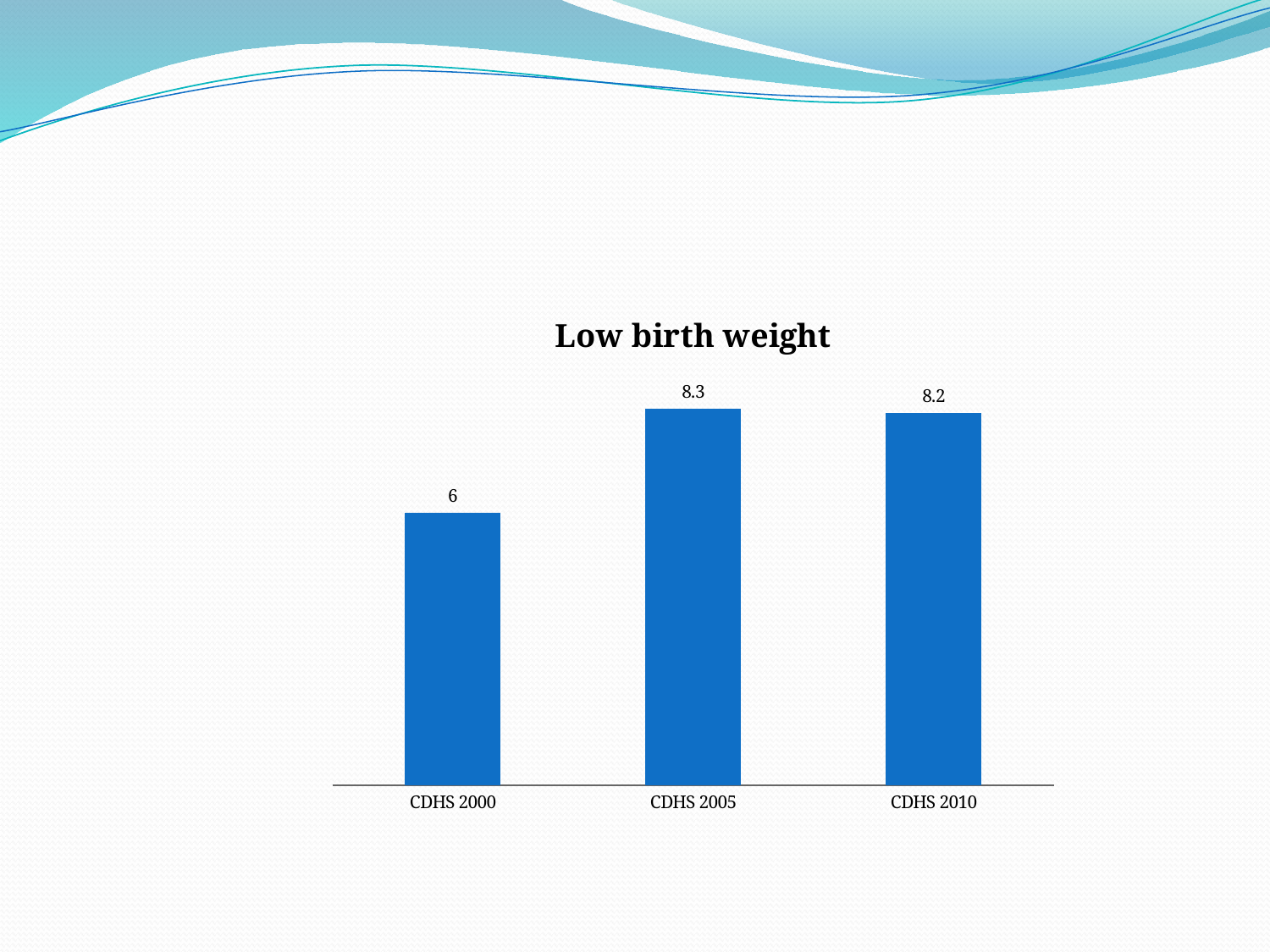
Does the value rise or fall from CDHS 2000 to CDHS 2005? Rise What is the difference between the values for CDHS 2005 and CDHS 2010? 0.1 Which category has the highest value? CDHS 2005 Which category has the lowest value? CDHS 2000 What is the difference between the values for CDHS 2005 and CDHS 2000? 2.3 What is the title of the chart? Low birth weight What is the value for CDHS 2000? 6 What kind of chart is shown on the slide? Bar chart What is the value for CDHS 2005? 8.3 How many categories are shown on the x axis? 3 Which is larger, the value for CDHS 2000 or the value for CDHS 2010? CDHS 2010 What is the value for CDHS 2010? 8.2